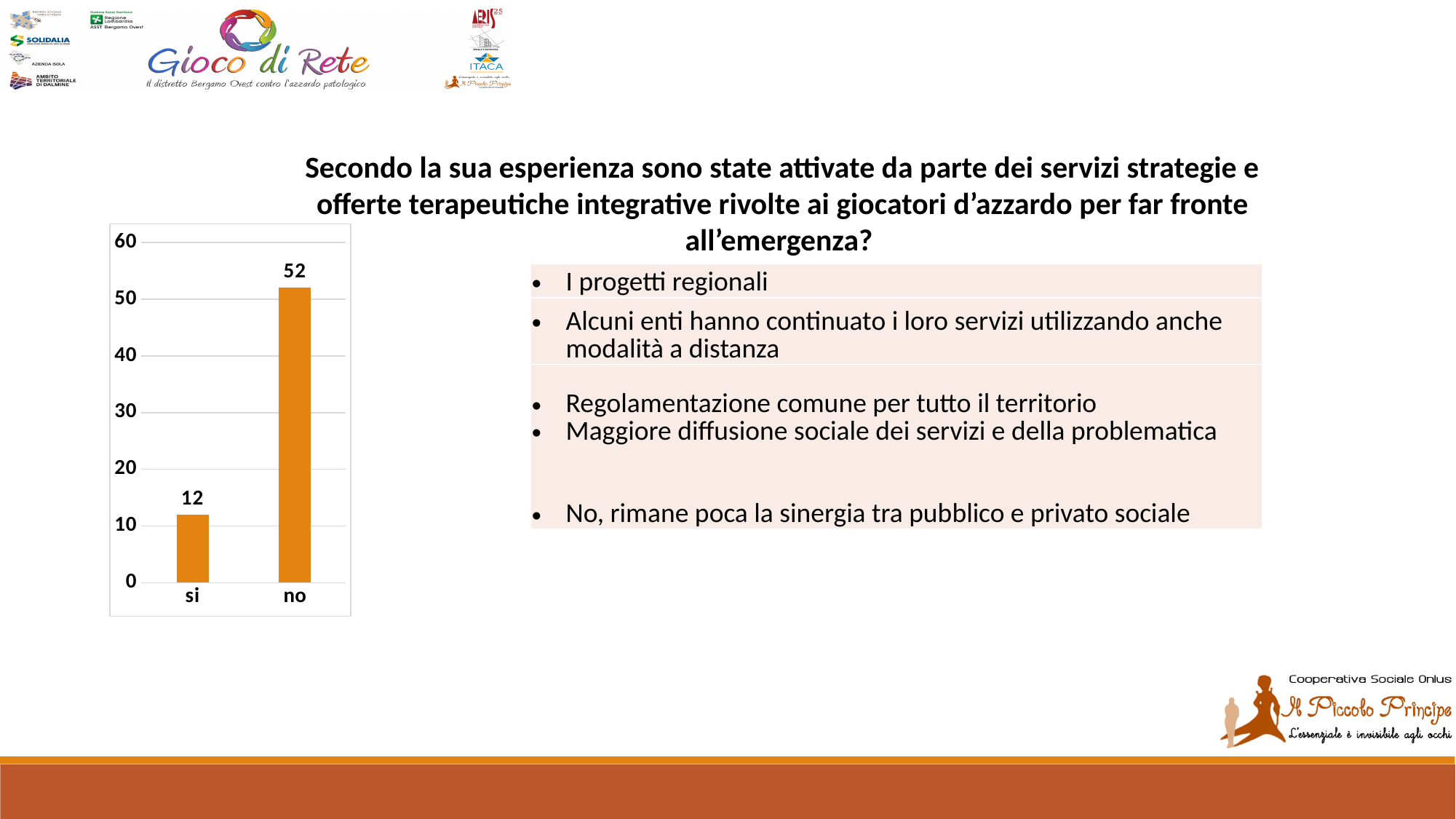
Is the value for "no" greater or less than 50? greater What is the total of the two bar values? 64 Which category has the highest value? no What kind of chart is shown on the slide? bar chart How many categories are shown on the x axis? 2 Is the value for "si" greater or less than 20? less What colour are the bars in the chart? orange What is the value for "no"? 52 Which is larger, the value for "si" or the value for "no"? no What is the difference between the values for "no" and "si"? 40 What is the value for "si"? 12 Which category has the lowest value? si